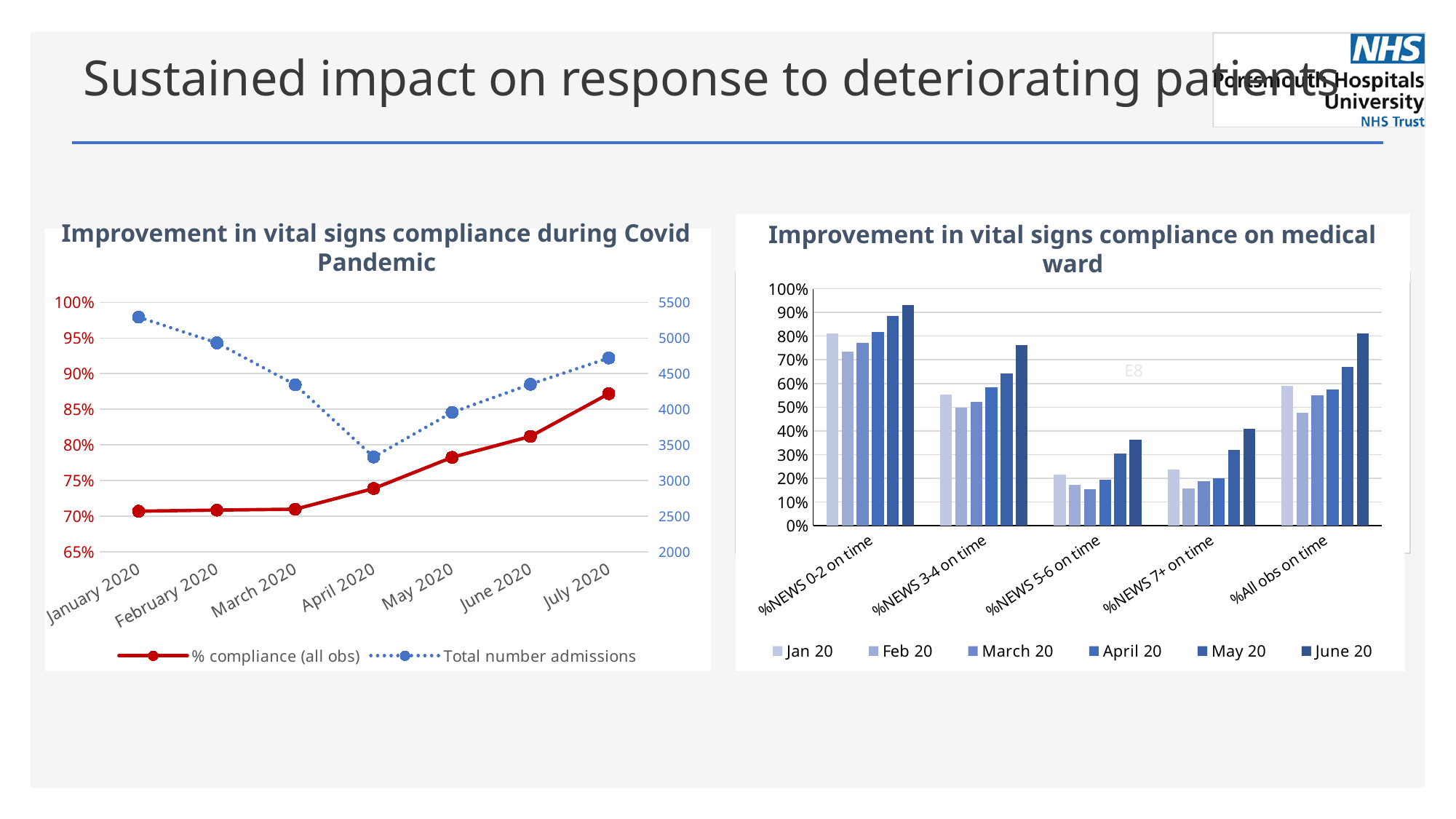
In the "Improvement in vital signs compliance during Covid Pandemic" chart, does the % compliance (all obs) rise or fall from January 2020 to July 2020? rise In the "Improvement in vital signs compliance during Covid Pandemic" chart, how many months are plotted on the x axis? 7 In the "Improvement in vital signs compliance during Covid Pandemic" chart, which month has the lowest total number of admissions? April 2020 In the "Improvement in vital signs compliance during Covid Pandemic" chart, how many series does the legend list? 2 What kind of chart is "Improvement in vital signs compliance on medical ward"? bar chart In the "Improvement in vital signs compliance on medical ward" chart, which month has the highest bar for %NEWS 0-2 on time? June 20 In the "Improvement in vital signs compliance on medical ward" chart, is the June 20 value for %NEWS 3-4 on time greater or less than 70%? greater In the "Improvement in vital signs compliance on medical ward" chart, how many series does the legend list? 6 In the "Improvement in vital signs compliance during Covid Pandemic" chart, which month has the highest % compliance (all obs)? July 2020 In the "Improvement in vital signs compliance during Covid Pandemic" chart, is the % compliance (all obs) for July 2020 greater or less than 85%? greater What kind of chart is "Improvement in vital signs compliance during Covid Pandemic"? line chart In the "Improvement in vital signs compliance during Covid Pandemic" chart, is the total number of admissions for January 2020 greater or less than 5000? greater